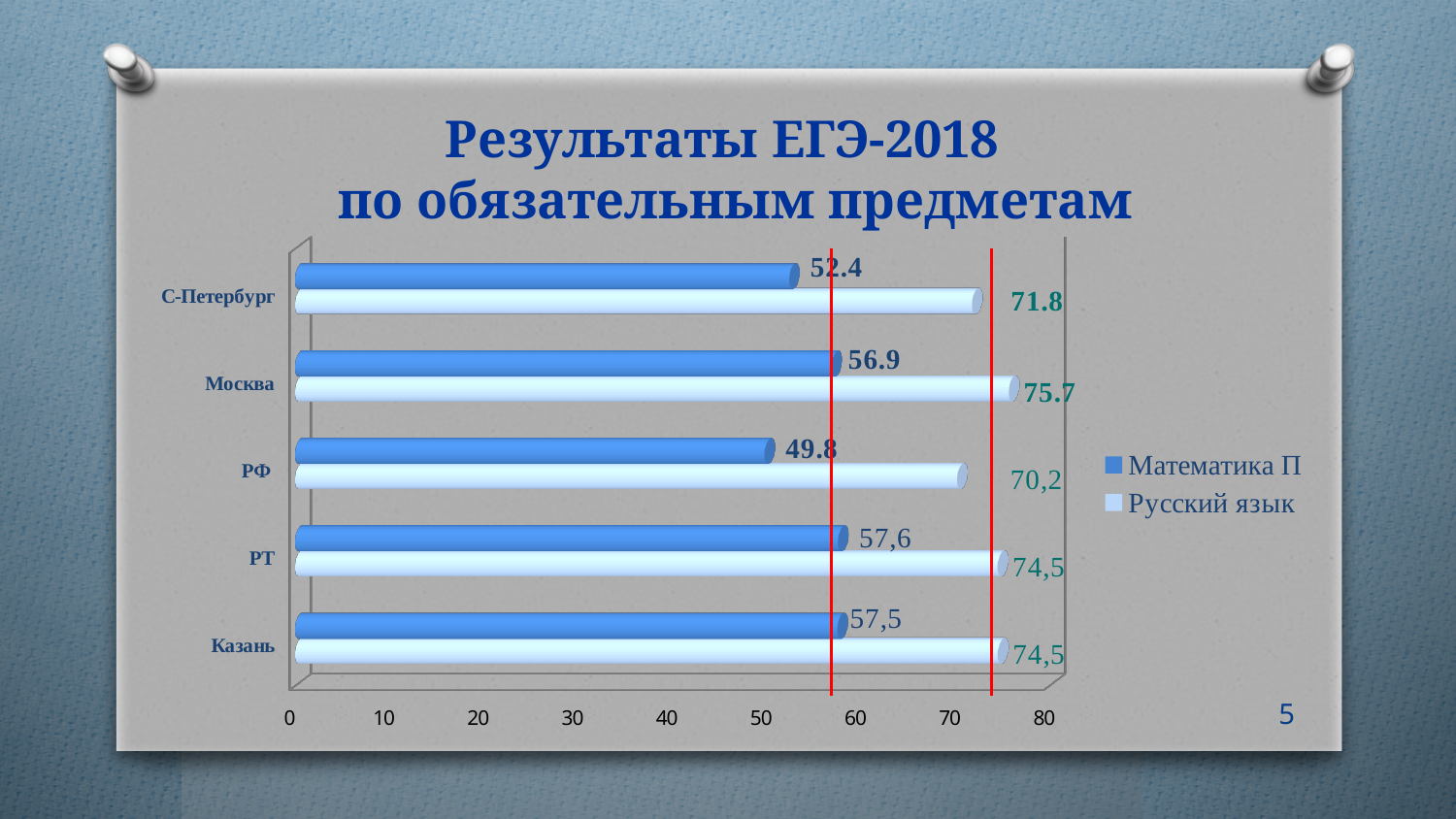
What is the value for Русский язык for РФ? 70,2 What is the value for Математика П for Москва? 56.9 What is the value for Русский язык for С-Петербург? 71.8 How many categories are shown on the chart? 5 What is the difference between the Русский язык and Математика П values for Москва? 18.8 Is the value for Русский язык for Казань greater or less than 70? greater Which category has the highest value for Русский язык? Москва What is the value for Математика П for Казань? 57,5 Which is larger: the Математика П value for Москва or for С-Петербург? Москва What kind of chart is shown on the slide? bar chart How many series does the legend list? 2 Which category has the lowest value for Математика П? РФ